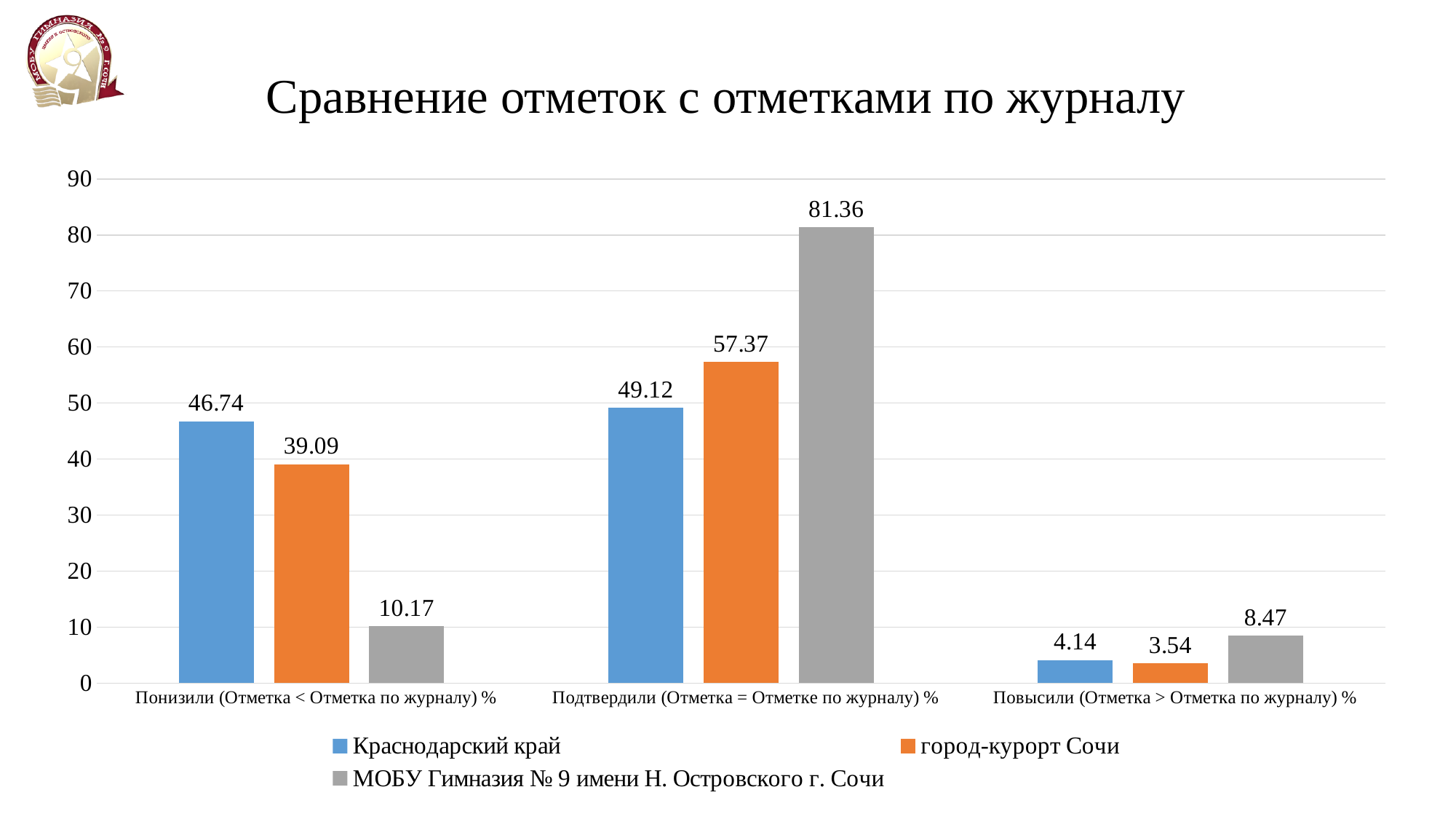
What is the value for Краснодарский край in the Понизили (Отметка < Отметка по журналу) % category? 46.74 How many series does the legend list? 3 What is the title of the chart? Сравнение отметок с отметками по журналу How many categories are shown on the x axis? 3 Which is larger in the Повысили (Отметка > Отметка по журналу) % category: Краснодарский край or МОБУ Гимназия № 9 имени Н. Островского г. Сочи? МОБУ Гимназия № 9 имени Н. Островского г. Сочи What kind of chart is shown on the slide? bar chart Which series has the highest value in the Подтвердили (Отметка = Отметке по журналу) % category? МОБУ Гимназия № 9 имени Н. Островского г. Сочи What is the value for МОБУ Гимназия № 9 имени Н. Островского г. Сочи in the Подтвердили (Отметка = Отметке по журналу) % category? 81.36 What is the difference between the город-курорт Сочи and Краснодарский край values in the Подтвердили (Отметка = Отметке по журналу) % category? 8.25 Which series has the lowest value in the Понизили (Отметка < Отметка по журналу) % category? МОБУ Гимназия № 9 имени Н. Островского г. Сочи Is the value for город-курорт Сочи in the Понизили (Отметка < Отметка по журналу) % category greater or less than 40? less What is the value for город-курорт Сочи in the Повысили (Отметка > Отметка по журналу) % category? 3.54